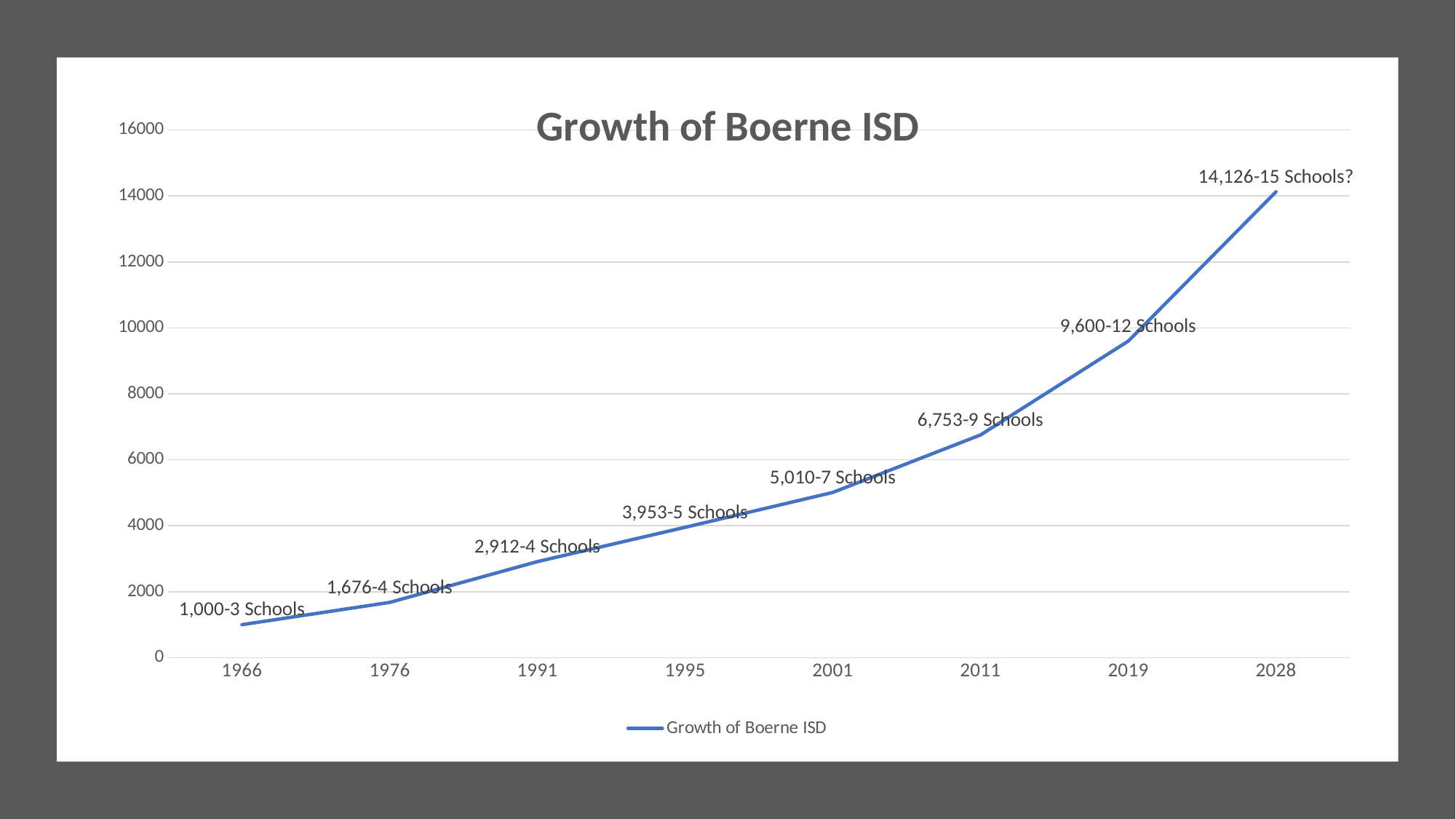
What is the data label for 2028? 14,126-15 Schools? How many schools are indicated in the data label for 2011? 9 Schools What is the data label shown for 1966 on the Growth of Boerne ISD chart? 1,000-3 Schools How many years are plotted along the x axis? 8 Do the values rise or fall from 1966 to 2028? rise What enrollment value is labelled for 2019? 9,600 What kind of chart is shown on the slide? line chart Which year has the lowest value on the chart? 1966 Which is larger, the value for 1995 or the value for 2001? 2001 Is the value for 1991 greater or less than 4000? less Which year has the highest value on the chart? 2028 What is the difference between the enrollment values labelled for 2019 and 2011? 2,847